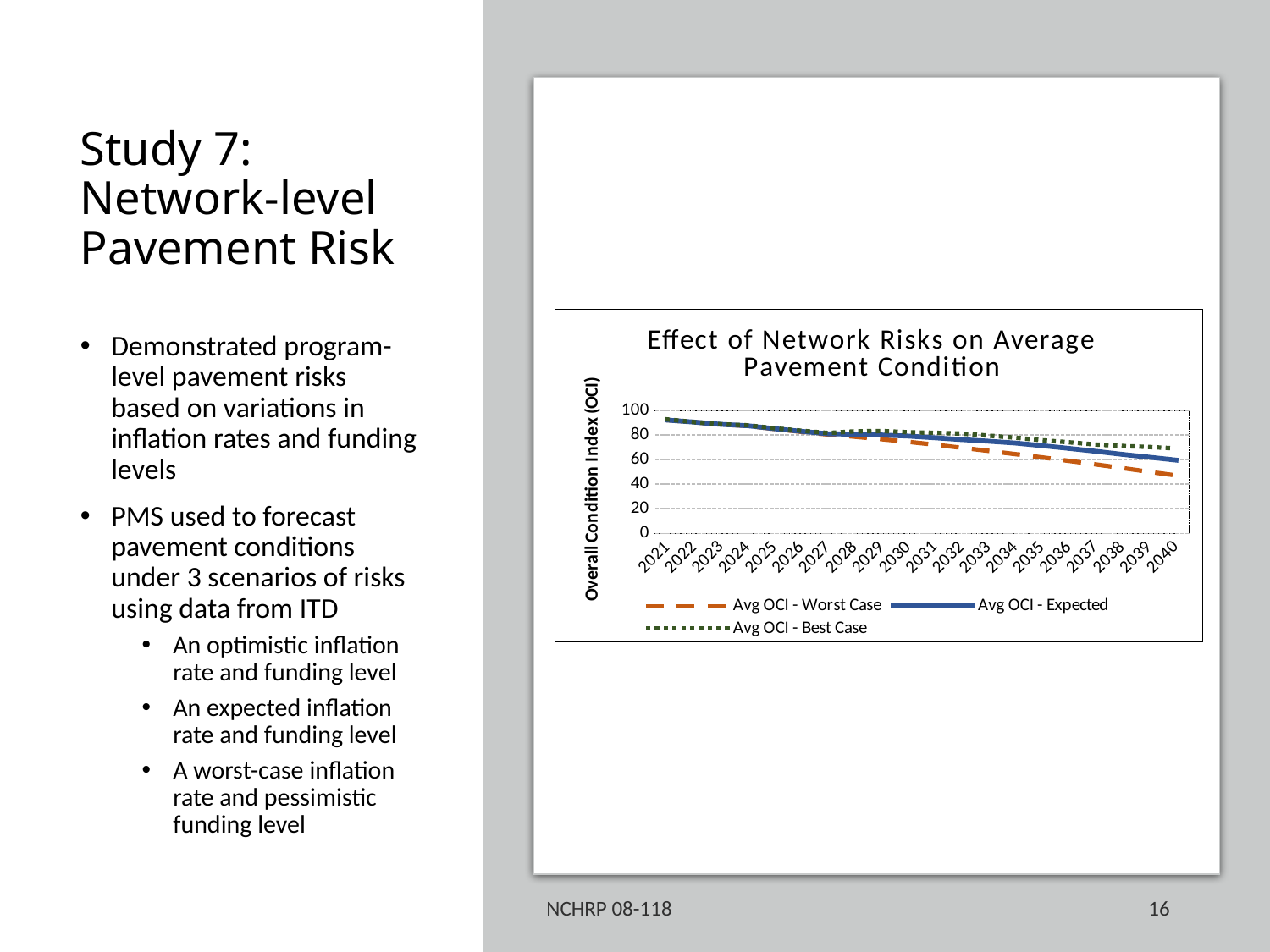
Is the value for Avg OCI - Best Case in 2040 greater or less than 60? greater Is the value for Avg OCI - Expected in 2021 greater or less than 80? greater In 2040, which is larger: Avg OCI - Best Case or Avg OCI - Worst Case? Avg OCI - Best Case What kind of chart is shown on the slide? line chart Which series has the highest value in 2040? Avg OCI - Best Case What is the label on the y axis of the chart? Overall Condition Index (OCI) How many years are plotted along the x axis of the chart? 20 Do the values for Avg OCI - Expected rise or fall from 2021 to 2040? fall Which series has the lowest value in 2040? Avg OCI - Worst Case How many series does the chart legend list? 3 What is the title of the chart? Effect of Network Risks on Average Pavement Condition Is the value for Avg OCI - Worst Case in 2040 greater or less than 60? less